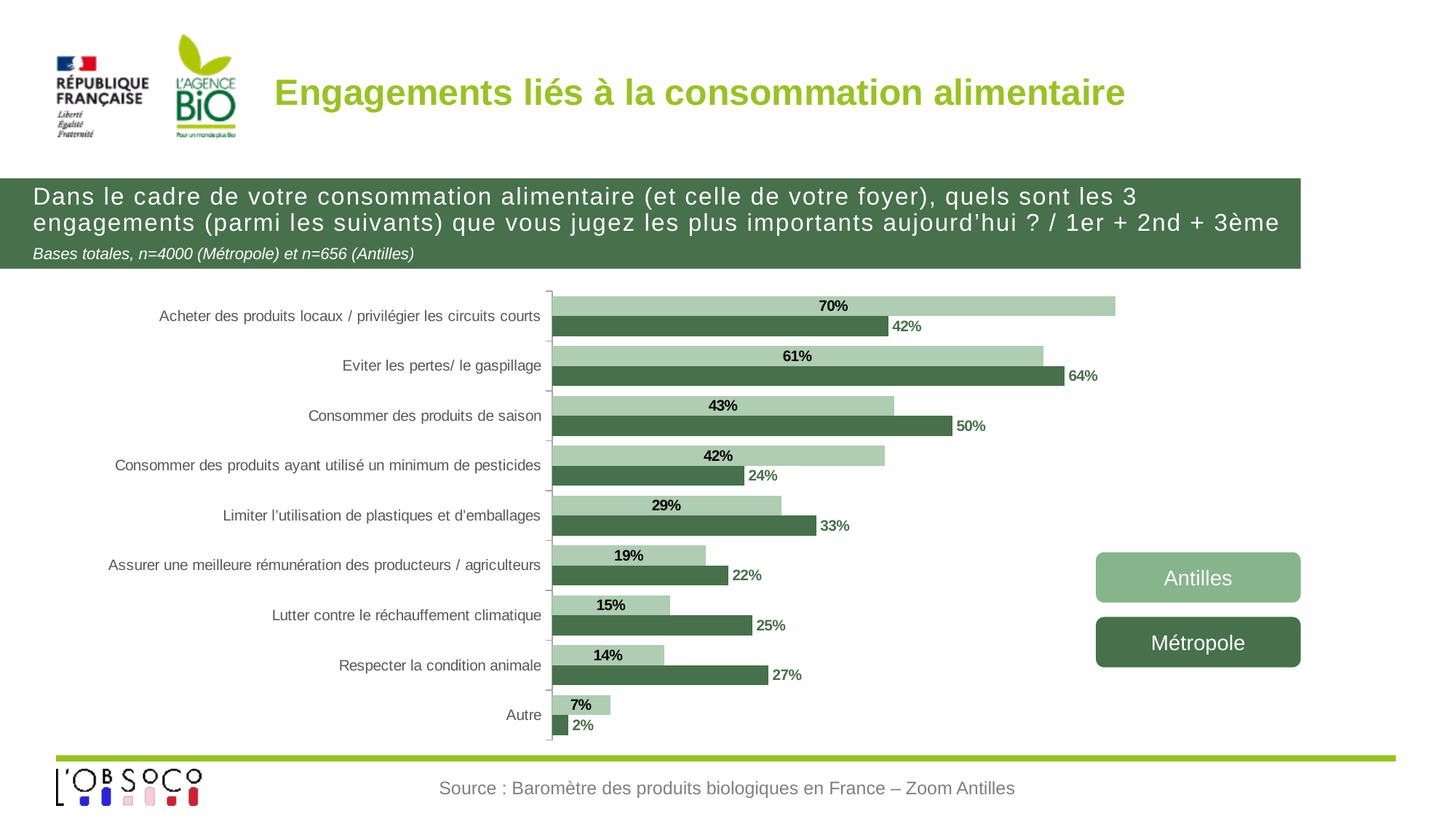
What is the Antilles value for "Acheter des produits locaux / privilégier les circuits courts"? 70% Which category has the lowest Métropole value? Autre What is the Métropole value for "Respecter la condition animale"? 27% What is the difference between the Antilles and Métropole values for "Acheter des produits locaux / privilégier les circuits courts"? 28% What is the Métropole value for "Eviter les pertes/ le gaspillage"? 64% For "Lutter contre le réchauffement climatique", which is larger: the Antilles value or the Métropole value? Métropole For "Consommer des produits de saison", which is larger: the Antilles value or the Métropole value? Métropole What is the difference between the Antilles and Métropole values for "Consommer des produits ayant utilisé un minimum de pesticides"? 18% What kind of chart is shown on the slide? Bar chart Which category has the highest Antilles value? Acheter des produits locaux / privilégier les circuits courts How many series does the legend list? 2 How many categories are shown in the chart? 9